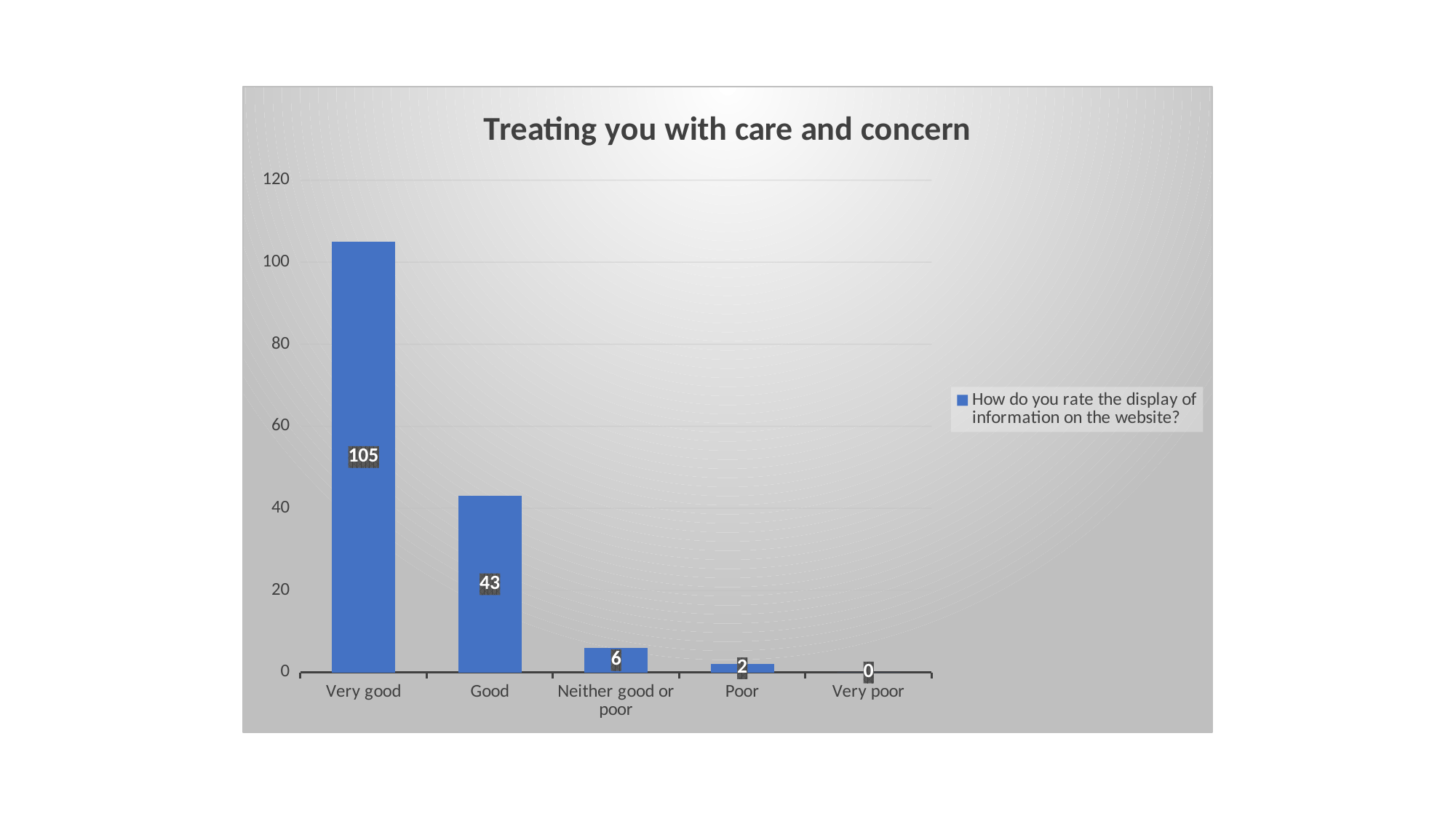
What is the value for Neither good or poor? 6 Which category has the highest value? Very good What is the difference between the values for Very good and Good? 62 Which is larger, the value for Good or the value for Neither good or poor? Good What is the title of the chart? Treating you with care and concern How many categories are shown on the x axis? 5 Which category has the lowest value? Very poor What is the value for Poor? 2 What is the value for Very good? 105 What kind of chart is shown on the slide? Bar chart What is the value for Good? 43 What is the value for Very poor? 0